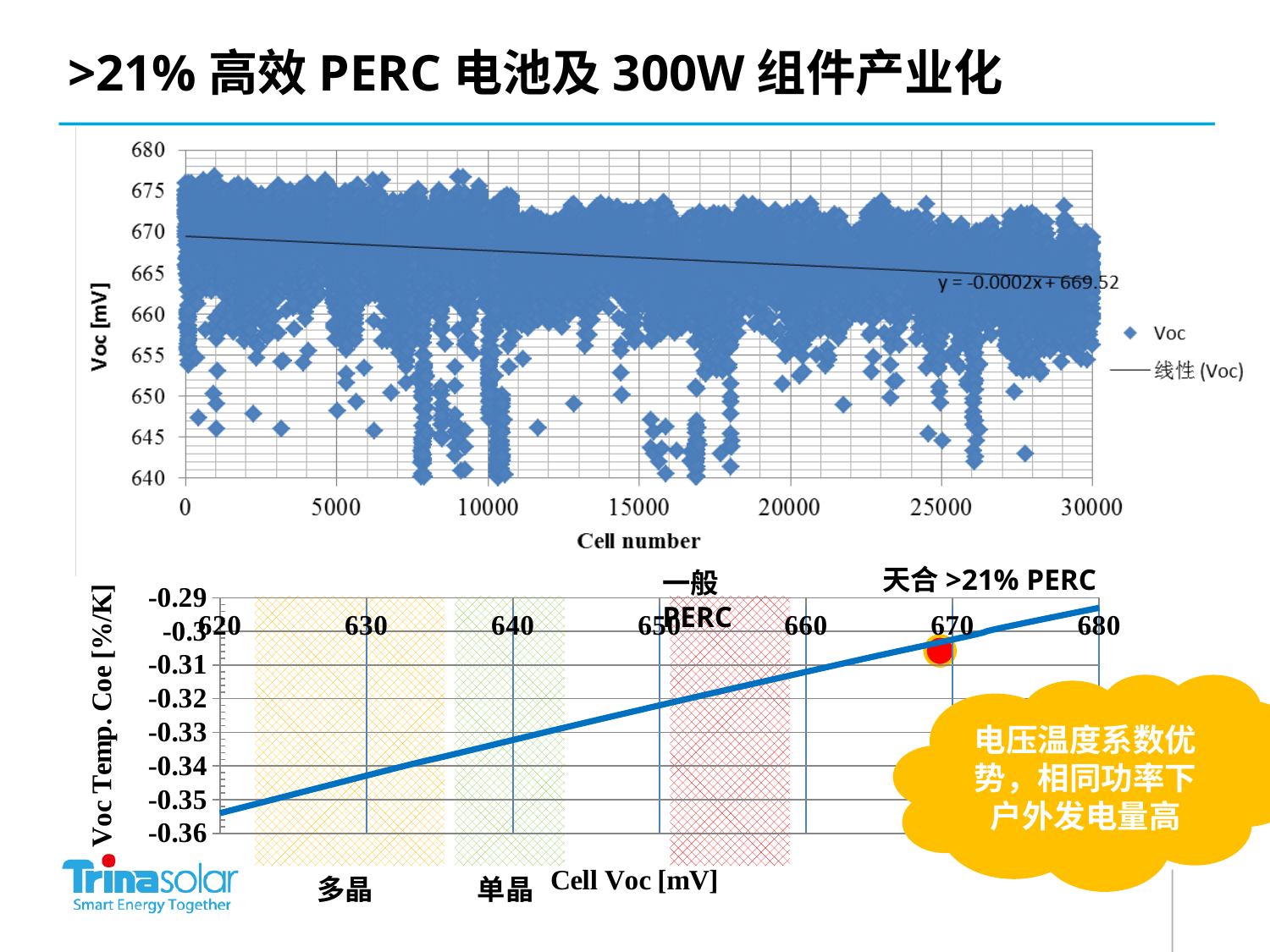
In the bottom chart, is the value of the line at a Cell Voc of 680 mV greater or less than -0.30? greater In the bottom chart, does the Voc temperature coefficient rise or fall as Cell Voc increases from 620 to 680 mV? rise In the top chart, what is the intercept of the trendline equation? 669.52 In the top chart, what is the label of the y axis? Voc [mV] In the top chart, does the trendline rise or fall as the cell number increases? fall What kind of chart is the bottom chart on the slide (Voc Temp. Coe vs Cell Voc)? line chart In the top chart, what is the equation of the linear trendline shown? y = -0.0002x + 669.52 What kind of chart is the top chart on the slide (Voc vs Cell number)? scatter chart In the bottom chart, is the value of the line at a Cell Voc of 620 mV greater or less than -0.34? less In the top chart, what is the label of the x axis? Cell number In the top chart, how many entries does the legend list? 2 How many charts are shown on the slide? 2